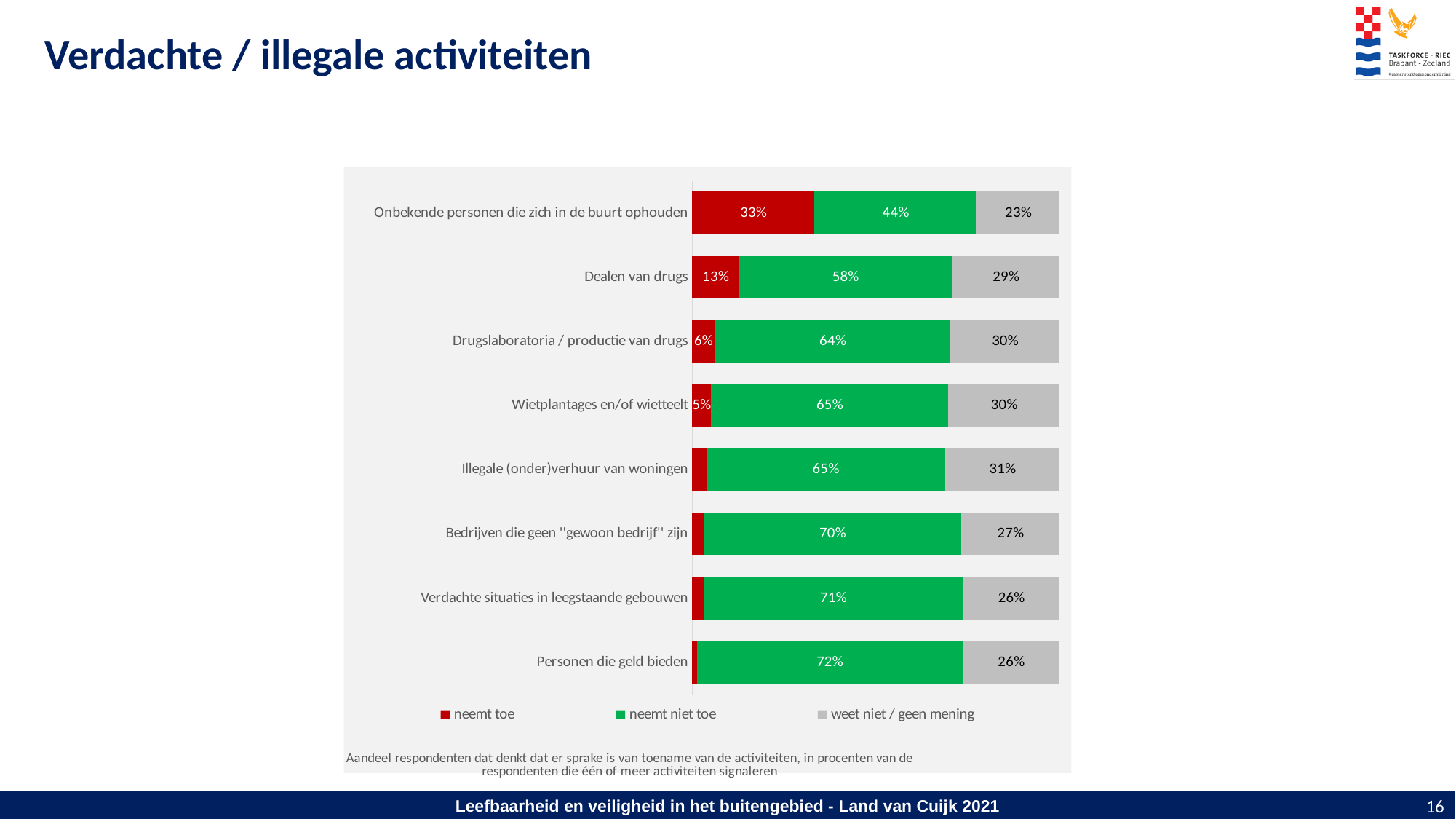
What is the 'weet niet / geen mening' value for 'Illegale (onder)verhuur van woningen'? 31% What is the 'neemt niet toe' value for 'Dealen van drugs'? 58% How many series does the legend list? 3 Which activity has the lowest 'weet niet / geen mening' value? Onbekende personen die zich in de buurt ophouden What is the difference between the 'neemt toe' values for 'Onbekende personen die zich in de buurt ophouden' and 'Dealen van drugs'? 20% Which series is shown in red in the chart? neemt toe Which is larger: the 'neemt niet toe' value for 'Drugslaboratoria / productie van drugs' or for 'Dealen van drugs'? Drugslaboratoria / productie van drugs What is the 'neemt toe' value for 'Onbekende personen die zich in de buurt ophouden'? 33% Which activity has the highest 'neemt niet toe' value? Personen die geld bieden What kind of chart is shown on the slide? stacked bar chart Which activity has the highest 'neemt toe' value? Onbekende personen die zich in de buurt ophouden How many categories (activities) are shown in the chart? 8